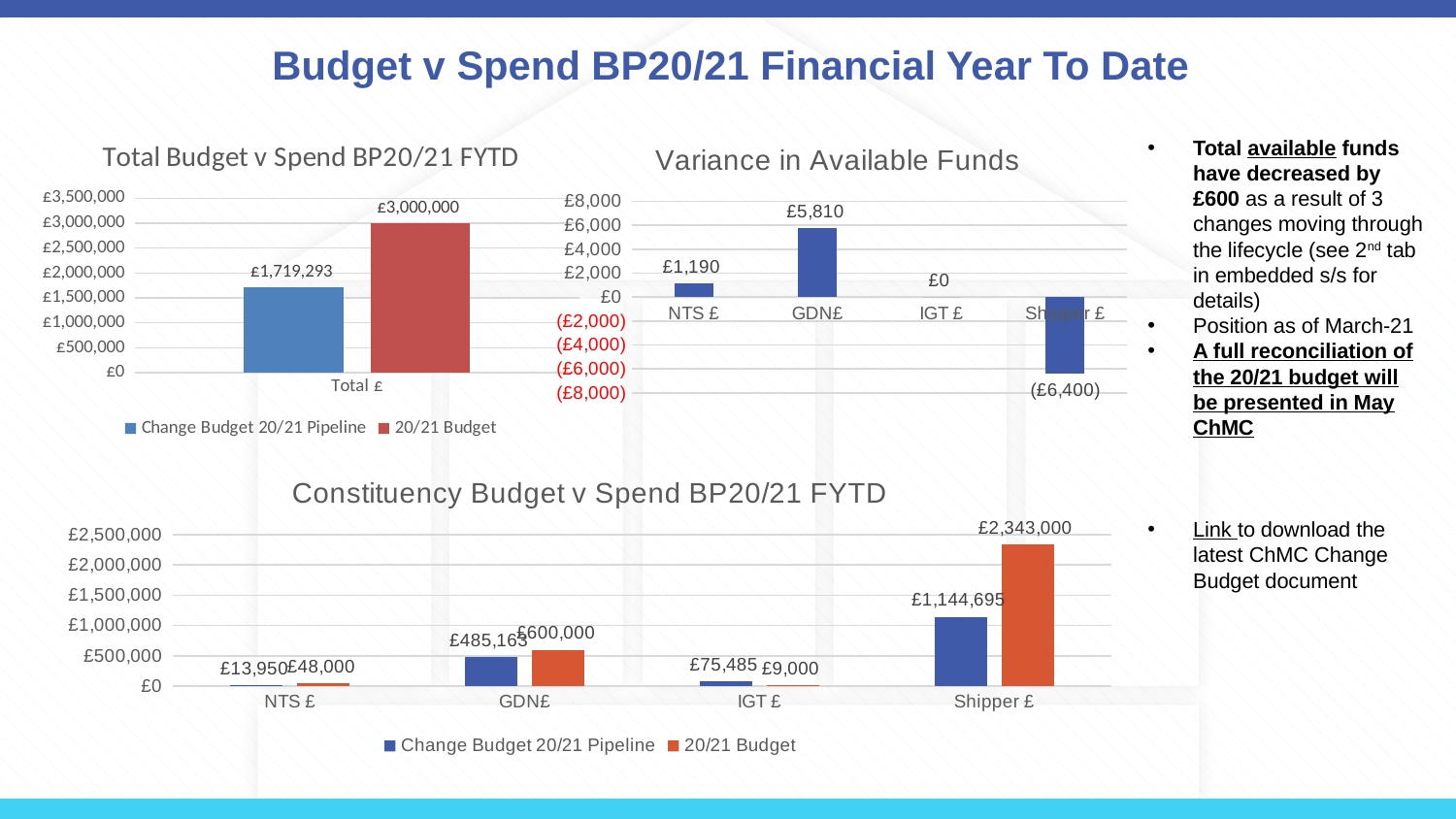
How many categories are shown in the 'Variance in Available Funds' chart? 4 In the 'Total Budget v Spend BP20/21 FYTD' chart, what is the value for 20/21 Budget? £3,000,000 In the 'Constituency Budget v Spend BP20/21 FYTD' chart, what is the Change Budget 20/21 Pipeline value for GDN£? £485,163 In the 'Constituency Budget v Spend BP20/21 FYTD' chart, which is larger for IGT £: the Change Budget 20/21 Pipeline or the 20/21 Budget? Change Budget 20/21 Pipeline How many series does the legend of the 'Constituency Budget v Spend BP20/21 FYTD' chart list? 2 In the 'Variance in Available Funds' chart, which category has the lowest value? Shipper £ In the 'Total Budget v Spend BP20/21 FYTD' chart, what is the difference between the 20/21 Budget and the Change Budget 20/21 Pipeline? £1,280,707 In the 'Variance in Available Funds' chart, which category has the highest value? GDN£ In the 'Total Budget v Spend BP20/21 FYTD' chart, what is the value for Change Budget 20/21 Pipeline? £1,719,293 In the 'Variance in Available Funds' chart, what is the value for GDN£? £5,810 In the 'Variance in Available Funds' chart, what is the value for Shipper £? (£6,400) In the 'Constituency Budget v Spend BP20/21 FYTD' chart, what is the 20/21 Budget value for Shipper £? £2,343,000